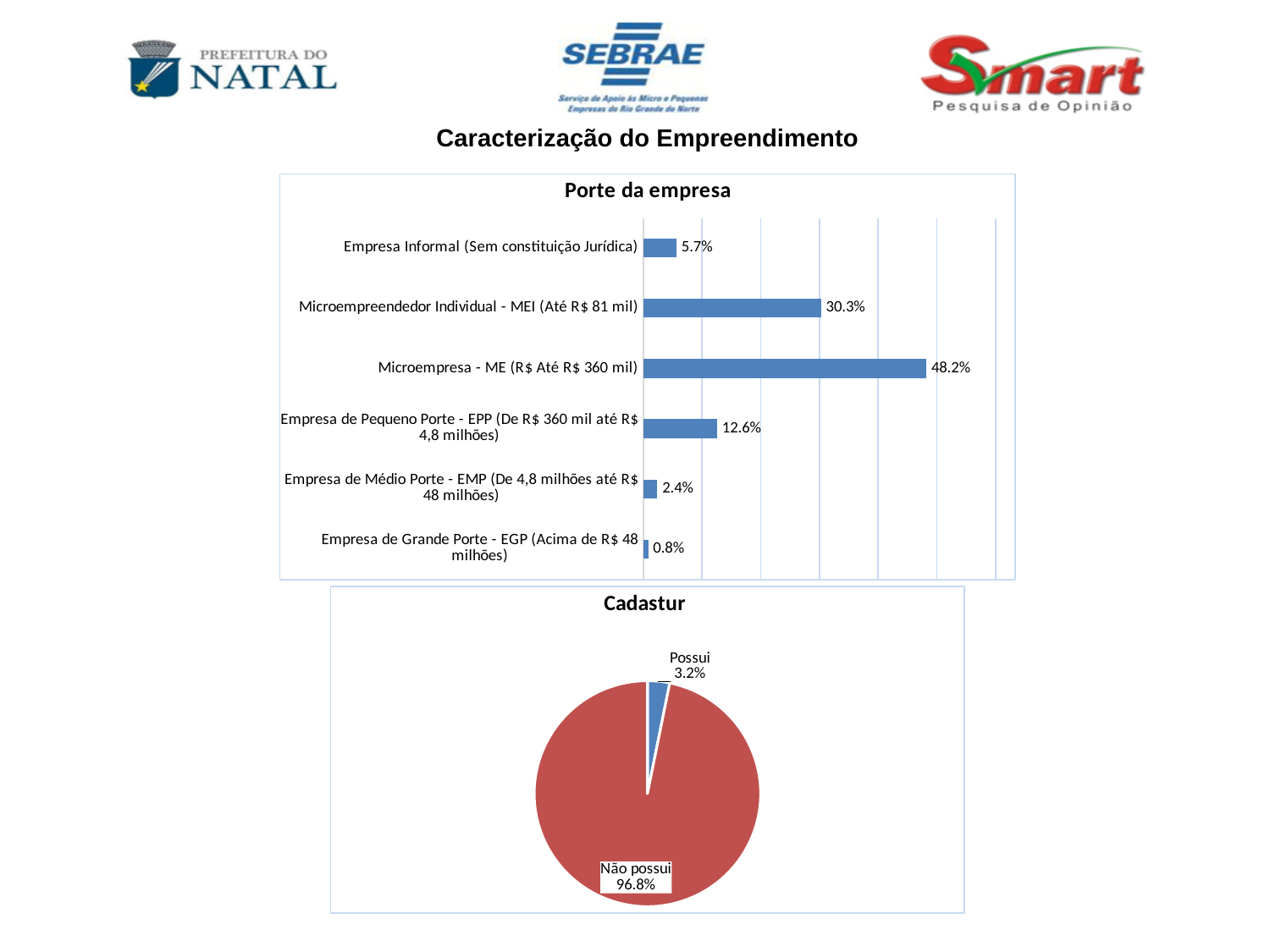
In the 'Cadastur' chart, what share of the pie is 'Não possui'? 96.8% How many categories are shown in the 'Porte da empresa' chart? 6 What kind of chart is the 'Cadastur' chart? Pie chart In the 'Porte da empresa' chart, what is the value for Empresa Informal (Sem constituição Jurídica)? 5.7% What kind of chart is the 'Porte da empresa' chart? Bar chart In the 'Cadastur' chart, what is the value for 'Possui'? 3.2% In the 'Porte da empresa' chart, which category has the lowest value? Empresa de Grande Porte - EGP (Acima de R$ 48 milhões) In the 'Porte da empresa' chart, what is the value for Microempreendedor Individual - MEI (Até R$ 81 mil)? 30.3% In the 'Porte da empresa' chart, which is larger: the value for Empresa de Pequeno Porte - EPP or the value for Empresa de Médio Porte - EMP? Empresa de Pequeno Porte - EPP In the 'Porte da empresa' chart, what is the difference between the values for Microempresa - ME and Microempreendedor Individual - MEI? 17.9% In the 'Porte da empresa' chart, what is the value for Microempresa - ME (R$ Até R$ 360 mil)? 48.2% In the 'Porte da empresa' chart, which category has the highest value? Microempresa - ME (R$ Até R$ 360 mil)